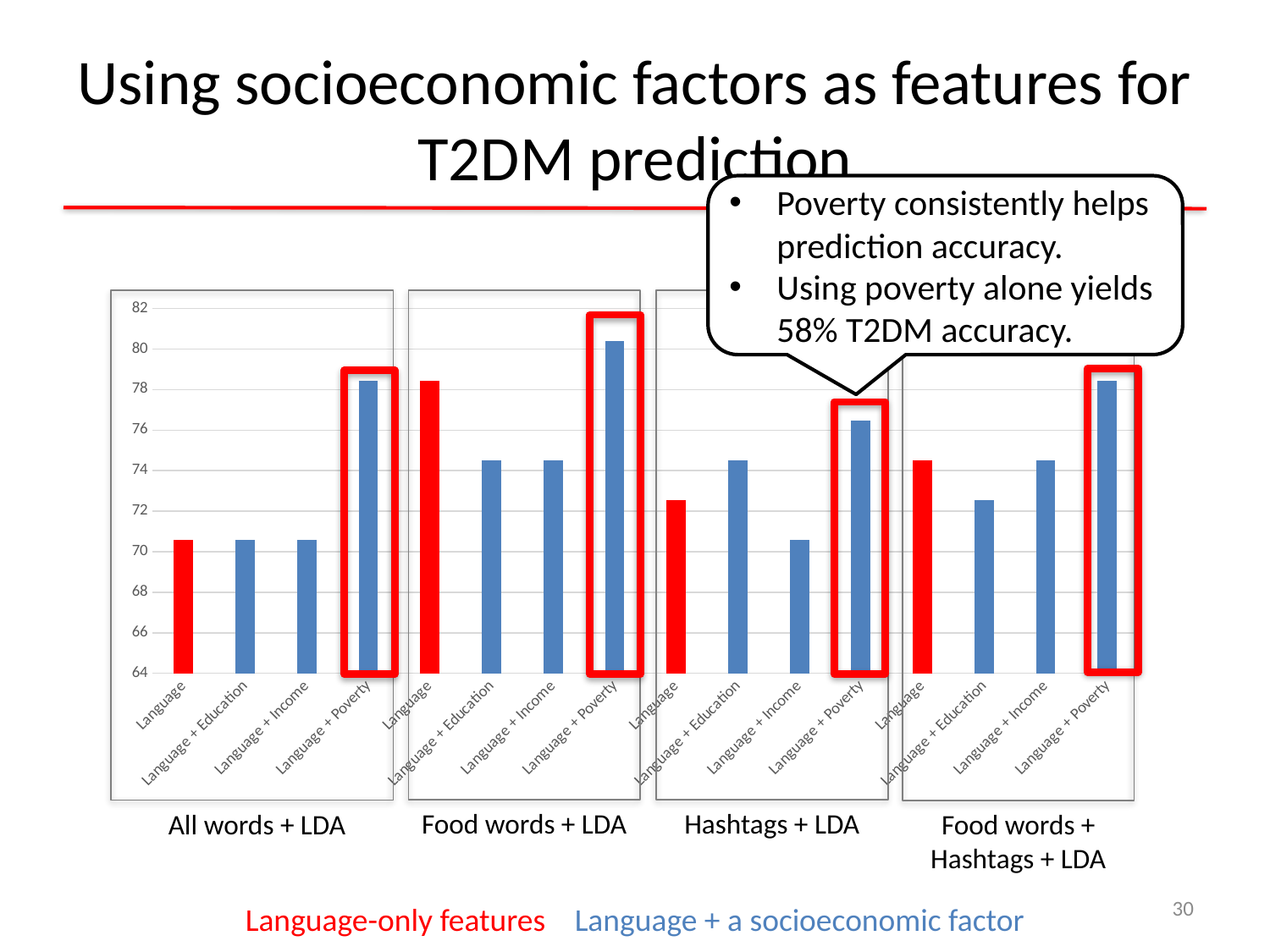
In the All words + LDA panel, is the value for Language greater or less than 72? less In the Food words + LDA panel, is the value for Language + Poverty greater or less than 78? greater In the All words + LDA panel, is the value for Language + Poverty greater or less than 76? greater In the All words + LDA panel, which feature set has the highest accuracy? Language + Poverty How many bars are plotted in the All words + LDA panel? 4 In the Hashtags + LDA panel, which is larger: Language + Education or Language + Income? Language + Education In the Food words + LDA panel, which is larger: Language or Language + Education? Language In the Food words + Hashtags + LDA panel, which feature set has the lowest accuracy? Language + Education In the Food words + LDA panel, which feature set has the highest accuracy? Language + Poverty In the Hashtags + LDA panel, which feature set has the lowest accuracy? Language + Income What colour are the bars for language-only features? red What kind of chart is used on this slide? bar chart